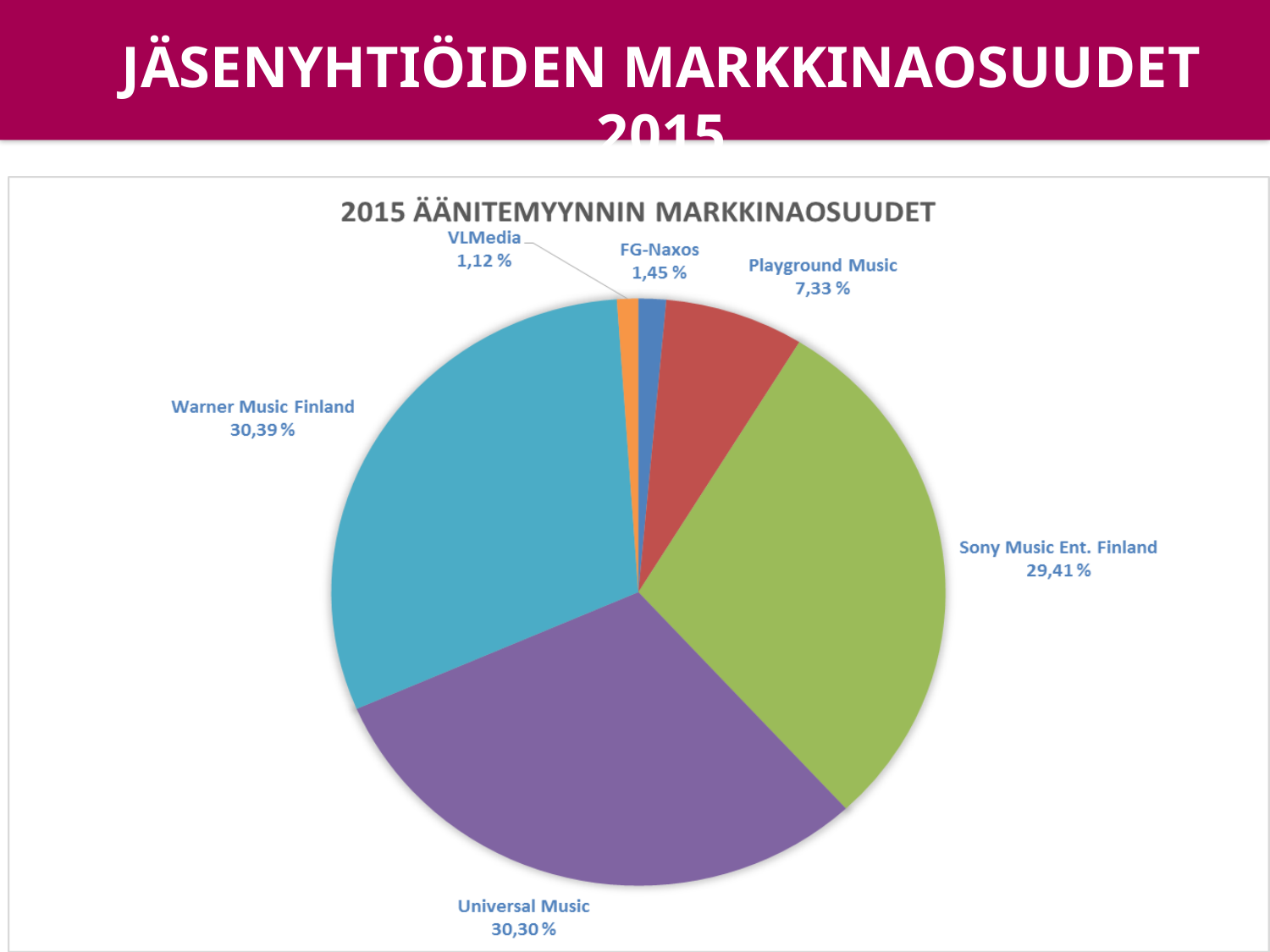
What is the title of the chart? 2015 ÄÄNITEMYYNNIN MARKKINAOSUUDET What kind of chart is shown on the slide? Pie chart What is the market share of Warner Music Finland? 30,39 % What is the difference in market share between Playground Music and FG-Naxos? 5,88 % How many slices does the pie chart have? 6 What share of the pie does Universal Music hold? 30,30 % Which company has the smallest market share? VLMedia What is the market share of Sony Music Ent. Finland? 29,41 % What is the market share of Playground Music? 7,33 % Which has a larger market share, Sony Music Ent. Finland or Playground Music? Sony Music Ent. Finland What is the difference in market share between Sony Music Ent. Finland and Playground Music? 22,08 % Which has a larger market share, Playground Music or FG-Naxos? Playground Music